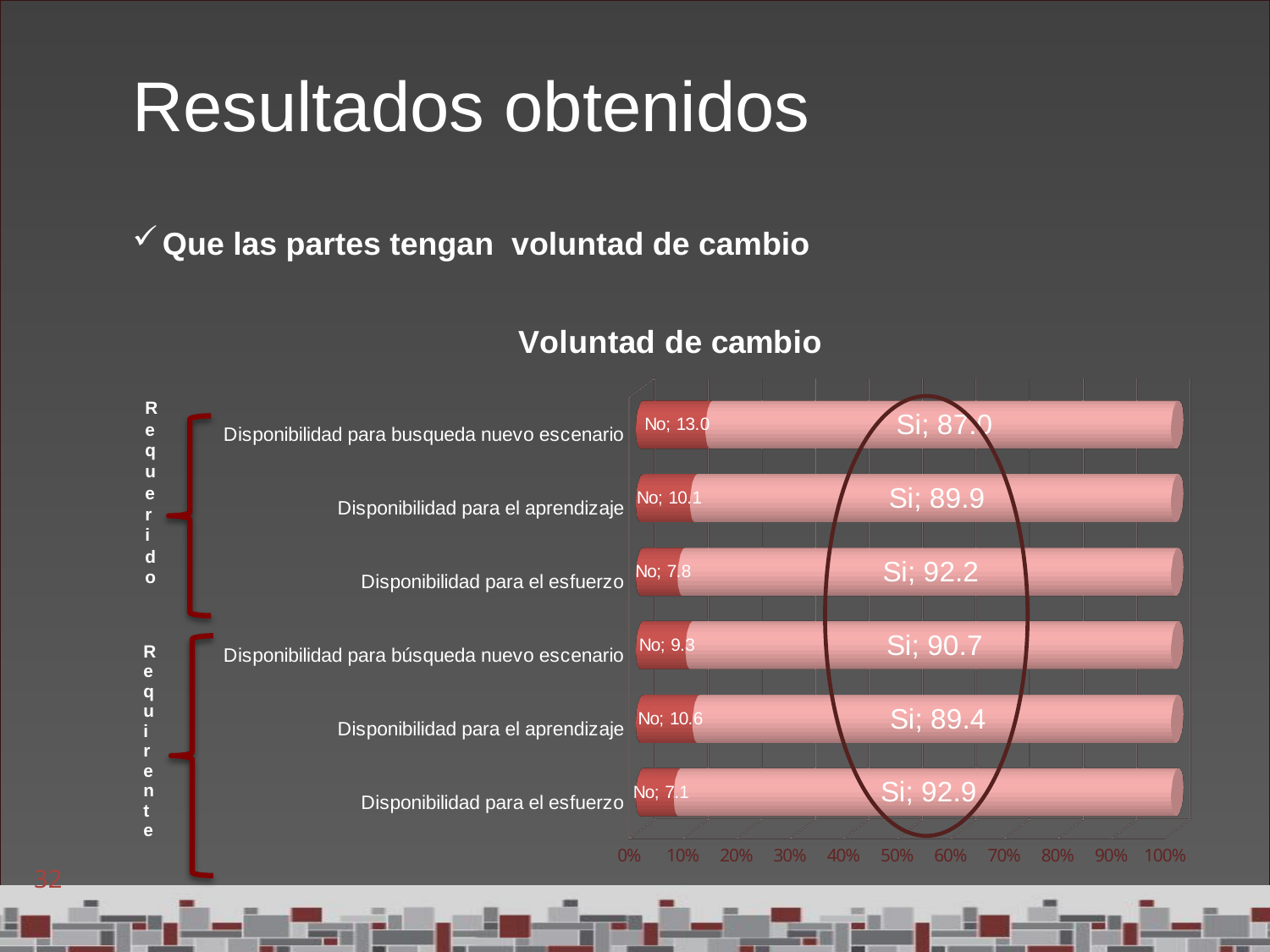
In the 'Voluntad de cambio' chart, what is the total of the 'No' and 'Si' segments for 'Disponibilidad para el esfuerzo' in the Requirente group? 100.0 In the 'Voluntad de cambio' chart, which bar has the lowest 'No' value? Disponibilidad para el esfuerzo (Requirente), 7.1 In the 'Voluntad de cambio' chart, what is the 'No' value for 'Disponibilidad para el aprendizaje' in the Requerido group? 10.1 In the 'Voluntad de cambio' chart, what is the difference between the 'Si' values for 'Disponibilidad para el esfuerzo' in the Requirente group and in the Requerido group? 0.7 How many bars are plotted in the 'Voluntad de cambio' chart? 6 In the 'Voluntad de cambio' chart, which has the larger 'No' value: 'Disponibilidad para el aprendizaje' in the Requerido group or in the Requirente group? Requirente group (10.6) In the 'Voluntad de cambio' chart, which bar has the highest 'Si' value? Disponibilidad para el esfuerzo (Requirente), 92.9 In the 'Voluntad de cambio' chart, what is the 'No' value for 'Disponibilidad para el aprendizaje' in the Requirente group? 10.6 In the 'Voluntad de cambio' chart, what is the 'Si' value for 'Disponibilidad para búsqueda nuevo escenario' in the Requirente group? 90.7 In the 'Voluntad de cambio' chart, which bar has the highest 'No' value? Disponibilidad para busqueda nuevo escenario (Requerido), 13.0 What kind of chart is 'Voluntad de cambio'? Stacked bar chart In the 'Voluntad de cambio' chart, what is the 'Si' value for 'Disponibilidad para el esfuerzo' in the Requerido group? 92.2